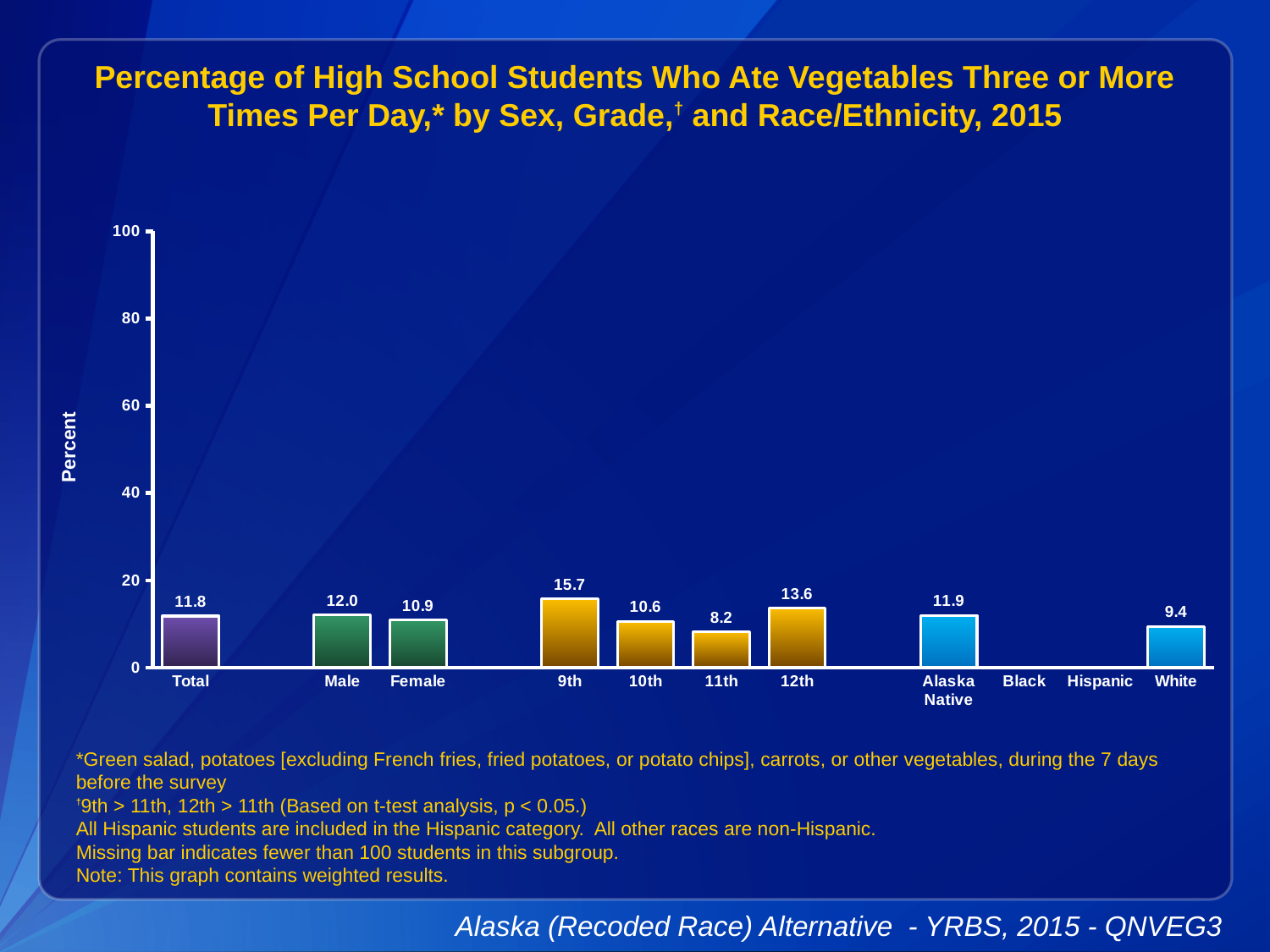
What is the difference between the values for Male and Female? 1.1 Is the value for White greater or less than 20? less How many categories are labelled on the x axis? 11 What is the value for Alaska Native? 11.9 What is the difference between the values for 9th and 11th grade? 7.5 Which category has the lowest value among those with bars? 11th Which category has the highest value? 9th What kind of chart is this? bar chart Which is larger, the value for 12th grade or the value for 10th grade? 12th Which categories have no bar shown? Black and Hispanic What is the value for 9th grade? 15.7 What is the value for Total? 11.8